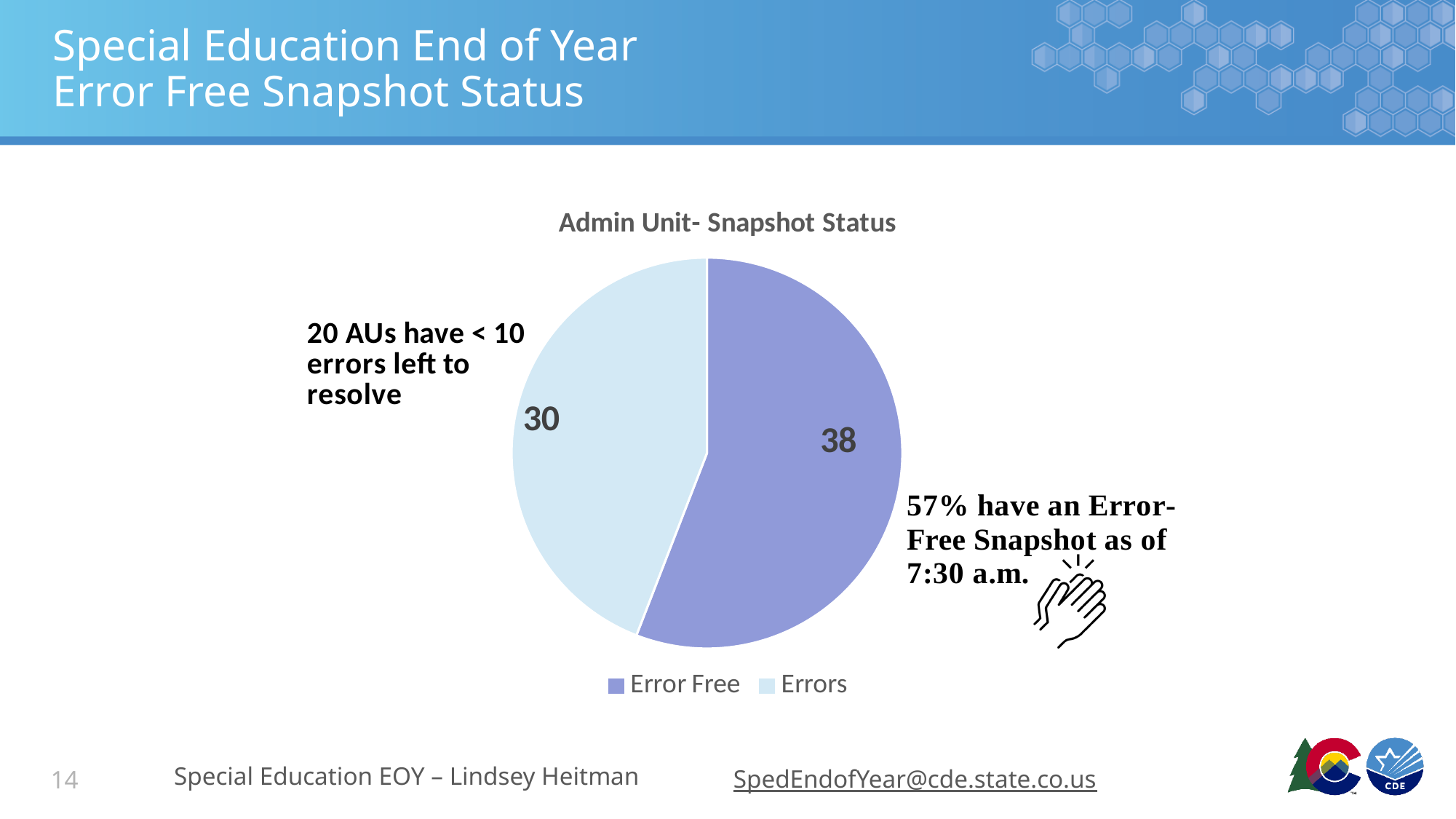
Which slice is the smallest? Errors How many slices does the pie chart have? 2 What is the difference between the Error Free and Errors values? 8 What colour is the Errors slice? light blue How many entries does the legend list? 2 What type of chart is shown on the slide? pie chart What is the value for Errors? 30 Which slice is the largest? Error Free What is the total of the two slices? 68 What is the title of the chart? Admin Unit- Snapshot Status What is the value for Error Free? 38 Which is larger, Error Free or Errors? Error Free